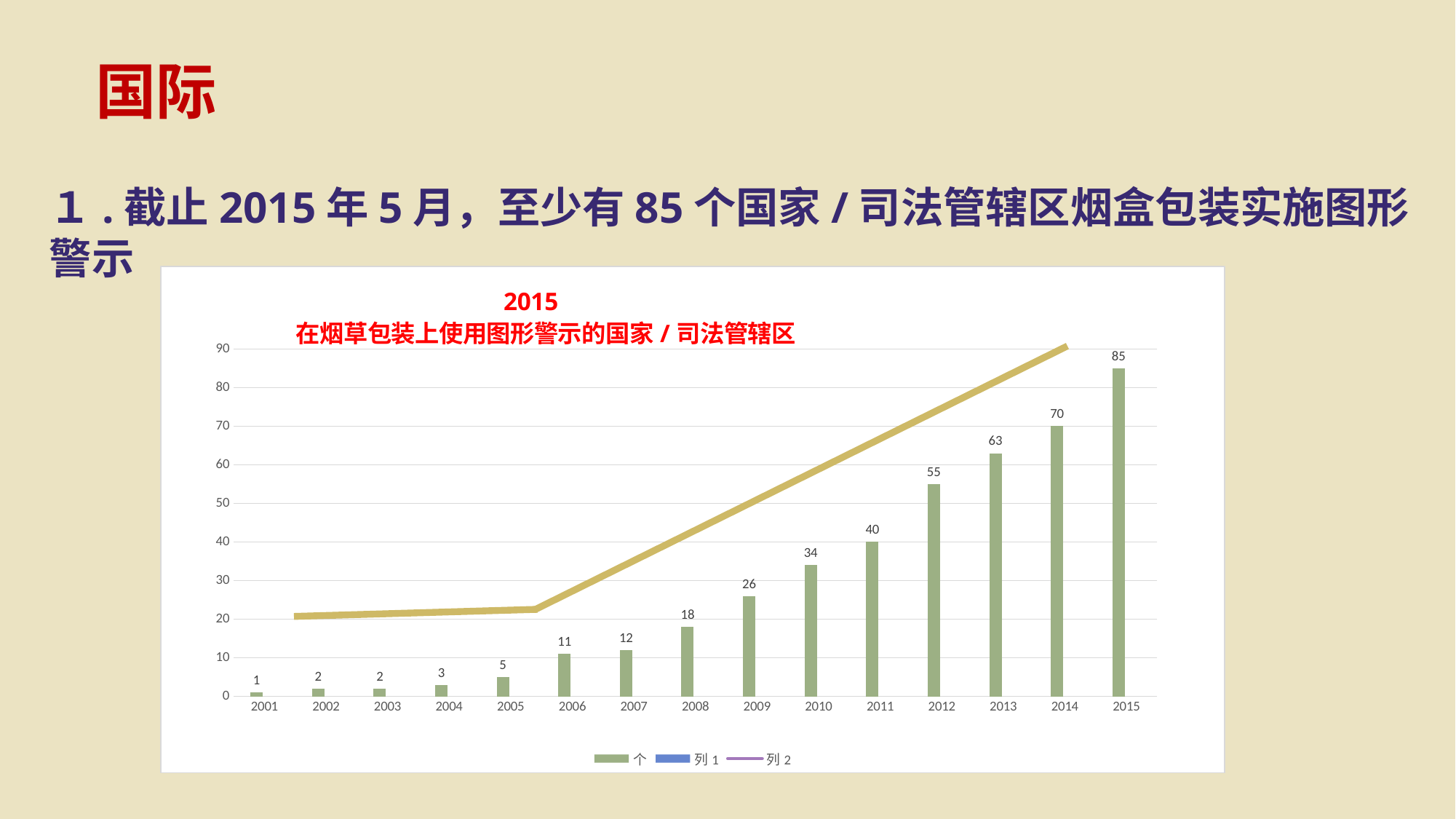
What is the value for 2005? 5 What is the value for 2015? 85 Which year has the highest value? 2015 What is the value for 2009? 26 What kind of chart is this? bar chart What is the difference between the values for 2015 and 2014? 15 Which year has the lowest value? 2001 How many entries does the legend list? 3 Which is larger, the value for 2008 or the value for 2011? 2011 How many years are shown on the x axis? 15 What is the difference between the values for 2012 and 2010? 21 Do the bar values rise or fall from 2001 to 2015? rise